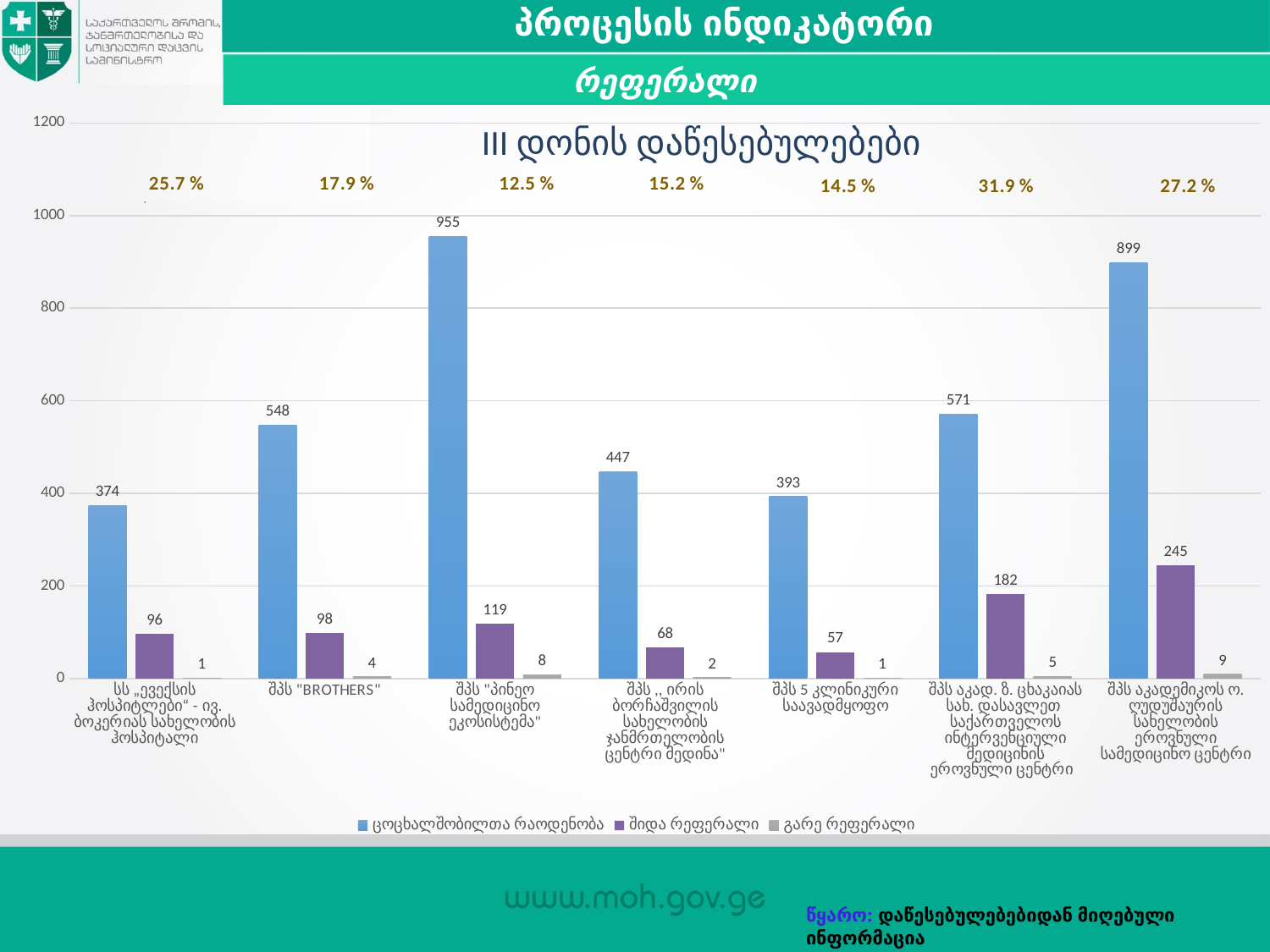
Which institution has the highest value of ცოცხალშობილთა რაოდენობა? შპს "პინეო სამედიცინო ეკოსისტემა" Which is larger: the შიდა რეფერალი value for შპს "BROTHERS" or for სს „ევექსის ჰოსპიტლები" - ივ. ბოკერიას სახელობის ჰოსპიტალი? შპს "BROTHERS" What percentage is printed above the bars for შპს აკად. ზ. ცხაკაიას სახ. დასავლეთ საქართველოს ინტერვენციული მედიცინის ეროვნული ცენტრი? 31.9 % How many series does the legend list? 3 What is the difference between the ცოცხალშობილთა რაოდენობა values for შპს "პინეო სამედიცინო ეკოსისტემა" and შპს "BROTHERS"? 407 Which institution has the lowest value of შიდა რეფერალი? შპს 5 კლინიკური საავადმყოფო What type of chart is shown on the slide? Bar chart What is the value of გარე რეფერალი for შპს "პინეო სამედიცინო ეკოსისტემა"? 8 What is the value of ცოცხალშობილთა რაოდენობა for შპს "BROTHERS"? 548 How many institutions (categories) are shown on the x axis? 7 What is the value of შიდა რეფერალი for შპს აკადემიკოს ო. ღუდუშაურის სახელობის ეროვნული სამედიცინო ცენტრი? 245 What is the title of the chart? III დონის დაწესებულებები